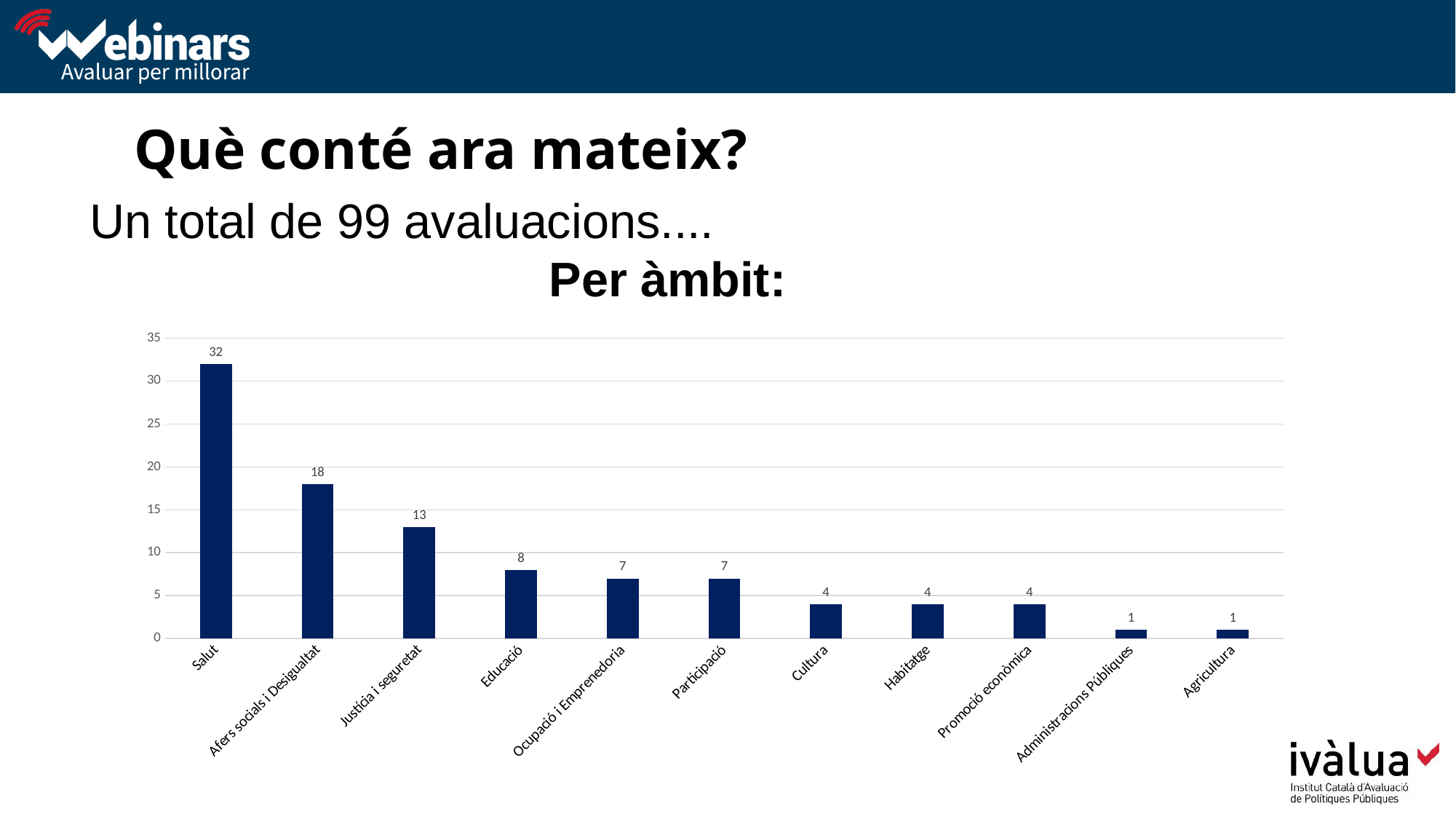
What kind of chart is shown on the slide? Bar chart What is the difference between the values for Salut and Afers socials i Desigualtat? 14 How many categories are shown on the x axis? 11 What is the value for Afers socials i Desigualtat? 18 Do the values rise or fall from left to right along the x axis? Fall Which category has the highest value? Salut What is the value for Salut? 32 What is the value for Justícia i seguretat? 13 What is the title of the chart? Per àmbit: What is the value for Educació? 8 Which is larger, the value for Educació or the value for Participació? Educació Is the value for Salut greater or less than 30? greater